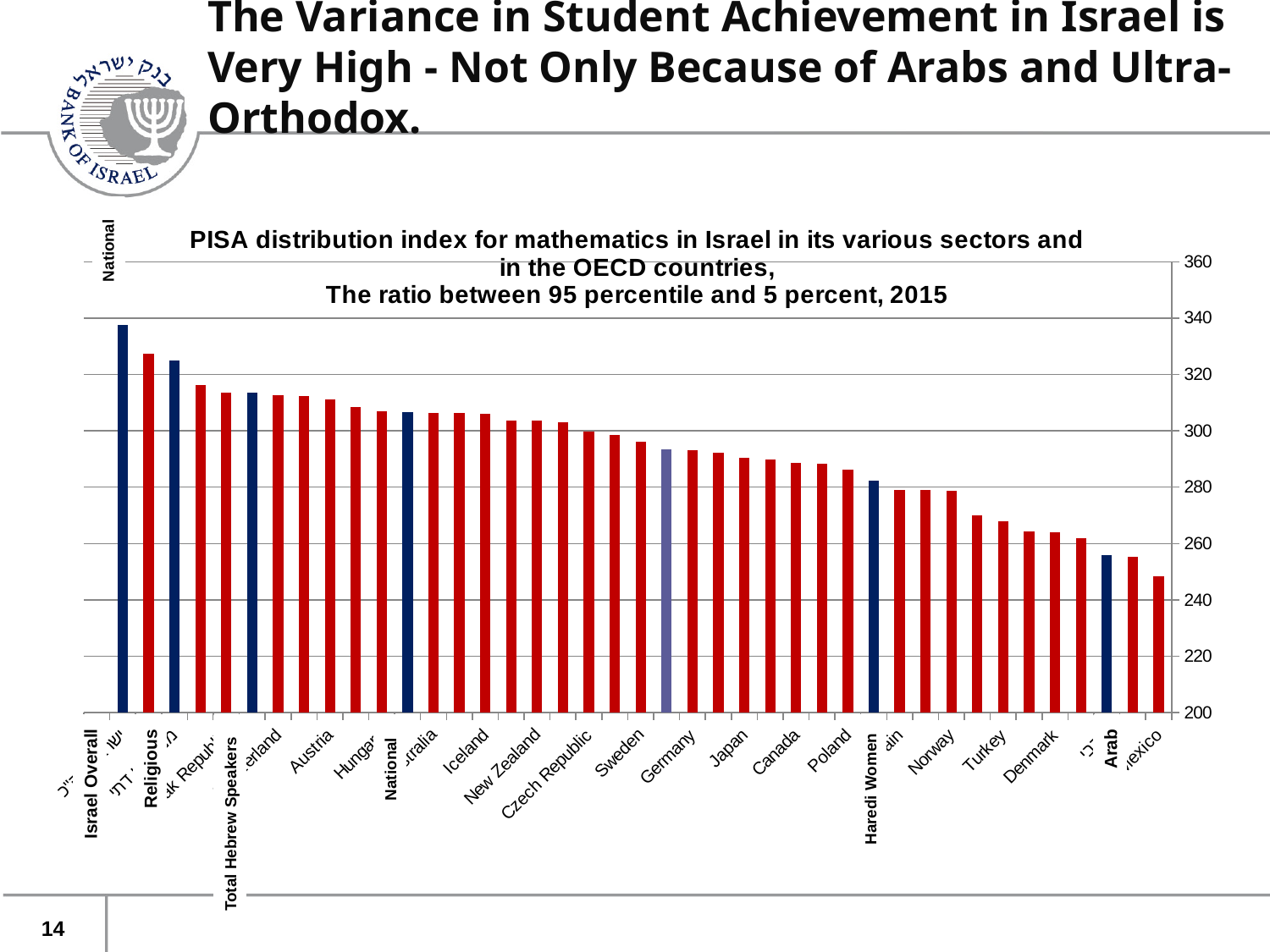
Is the value for Turkey greater or less than 280? less Which category has the highest value in the chart? Israel Overall Is the value for Haredi Women greater or less than 300? less Is the value for Religious greater or less than 320? greater What kind of chart is shown on the slide? bar chart Which is larger, the value for Israel Overall or the value for Arab? Israel Overall Which year does the chart title say the data refers to? 2015 Do the values generally rise or fall moving from left to right along the x axis? fall